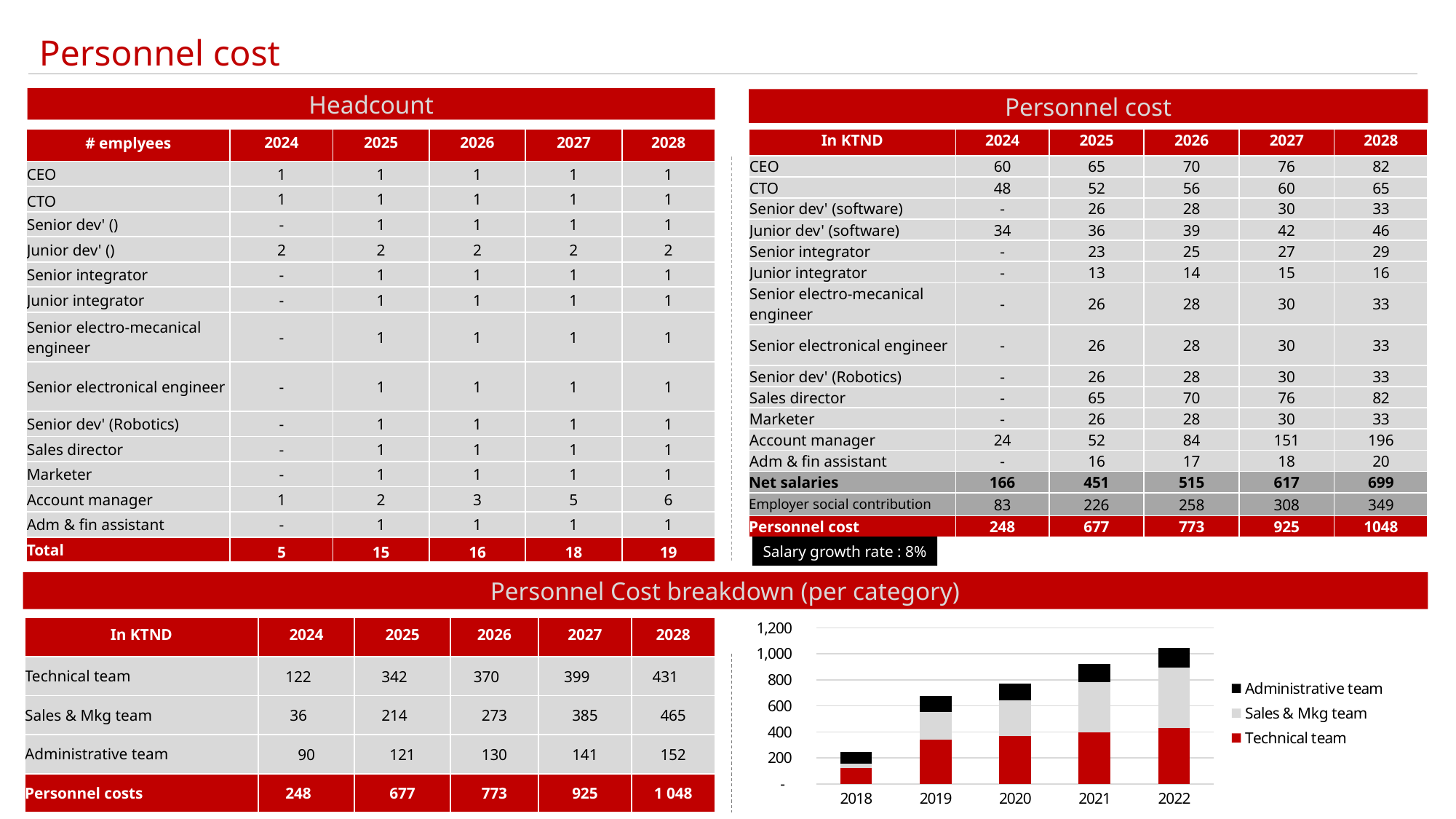
How many years are shown on the x axis of the chart? 5 Which series is shown in red in the chart? Technical team Which is taller in the chart, the total bar for 2021 or the total bar for 2019? 2021 Is the total stacked bar for 2019 greater or less than 600? greater How many series does the chart legend list? 3 Which year has the shortest stacked bar in the chart? 2018 Do the total bar heights rise or fall from 2018 to 2022 in the chart? rise What kind of chart is shown on the slide? stacked bar chart Which year has the tallest stacked bar in the chart? 2022 Is the total stacked bar for 2021 greater or less than 800? greater Is the Technical team segment for 2018 greater or less than 200? less